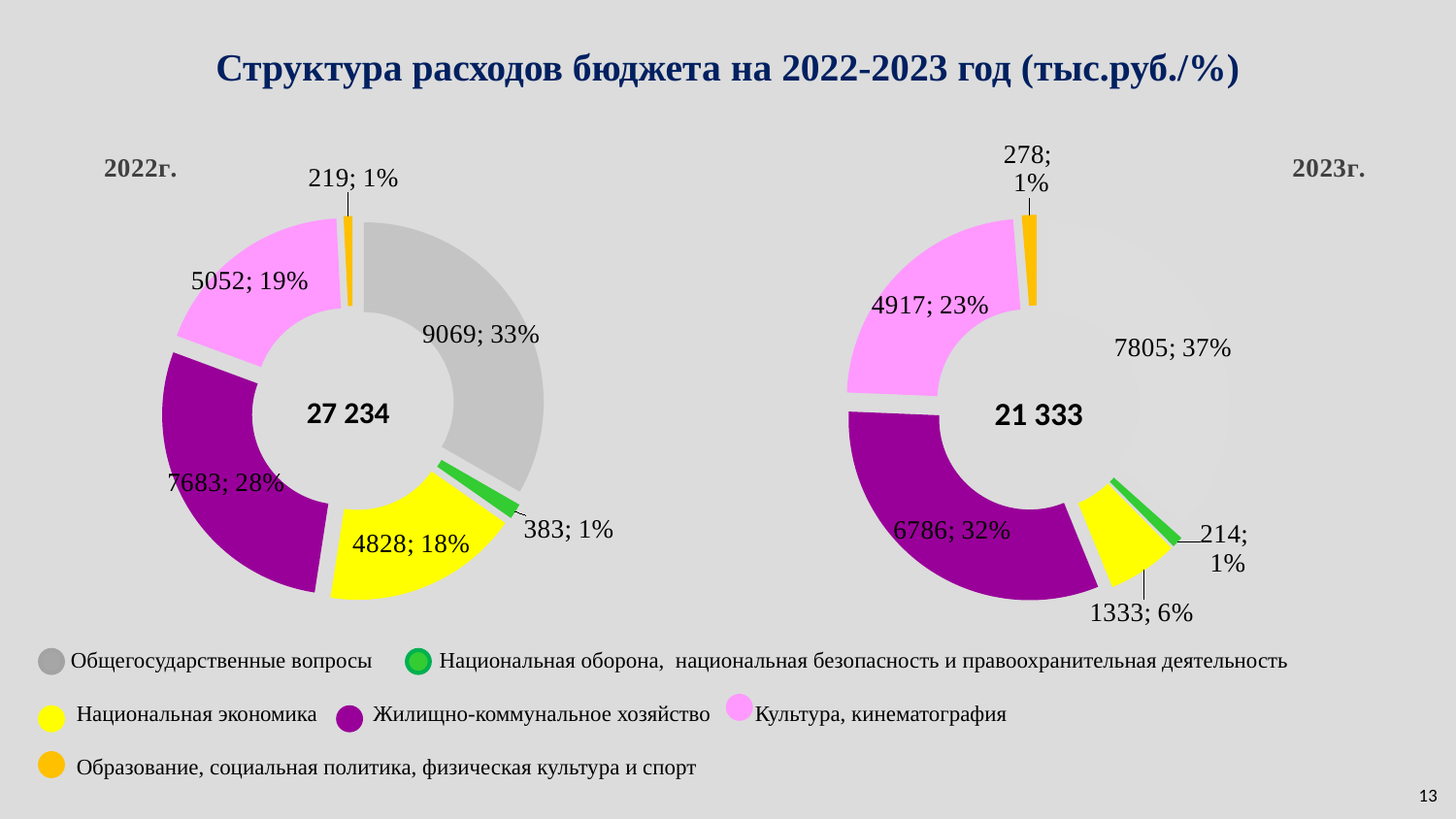
What is the difference between the Национальная экономика values in the 2022 chart and the 2023 chart? 3495 In the 2023 chart, what is the total shown in the centre of the doughnut? 21 333 In the 2022 chart, what is the total shown in the centre of the doughnut? 27 234 In the 2023 chart, what value is shown for Культура, кинематография? 4917; 23% What kind of chart is used for the 2022 data on the slide? Doughnut (pie) chart Which colour represents Образование, социальная политика, физическая культура и спорт in the charts? Orange Which is larger: Культура, кинематография in the 2022 chart or in the 2023 chart? 2022 (5052 vs 4917) What share of the 2023 chart does Национальная экономика represent? 6% How many categories does the legend list? 6 In the 2022 chart, what value is shown for Жилищно-коммунальное хозяйство? 7683; 28% In the 2023 chart, which category has the smallest value in thousand rubles? Национальная оборона, национальная безопасность и правоохранительная деятельность (214; 1%) In the 2022 chart, which category has the largest share? Общегосударственные вопросы (9069; 33%)